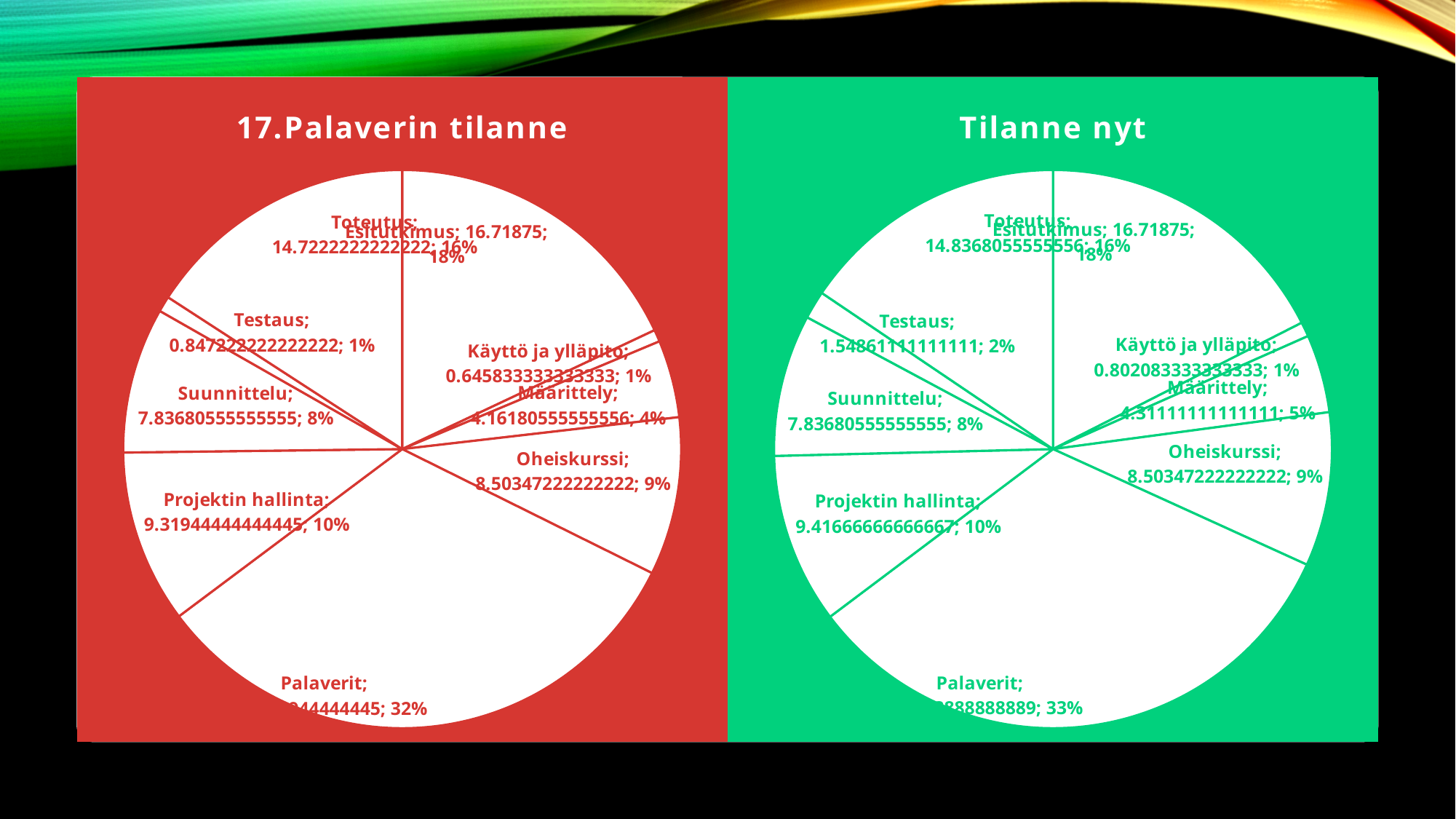
In the "Tilanne nyt" chart, what value is shown for Käyttö ja ylläpito? 0.802083333333333 What kind of chart is shown under the title "17.Palaverin tilanne"? pie chart In the "Tilanne nyt" chart, what share of the pie does Oheiskurssi take? 9% In the "17.Palaverin tilanne" chart, what value is shown for Projektin hallinta? 9.31944444444445 In the "Tilanne nyt" chart, what value is shown for Testaus? 1.54861111111111 In the "17.Palaverin tilanne" chart, what share of the pie does Palaverit take? 32% In the "Tilanne nyt" chart, which is larger: Suunnittelu or Oheiskurssi? Oheiskurssi Which category has the largest slice in the "Tilanne nyt" chart? Palaverit Which category has the smallest slice in the "17.Palaverin tilanne" chart? Käyttö ja ylläpito In the "17.Palaverin tilanne" chart, what value is shown for Määrittely? 4.16180555555556 How many slices does the "Tilanne nyt" pie chart have? 9 What is the title of the chart on the right side of the slide? Tilanne nyt